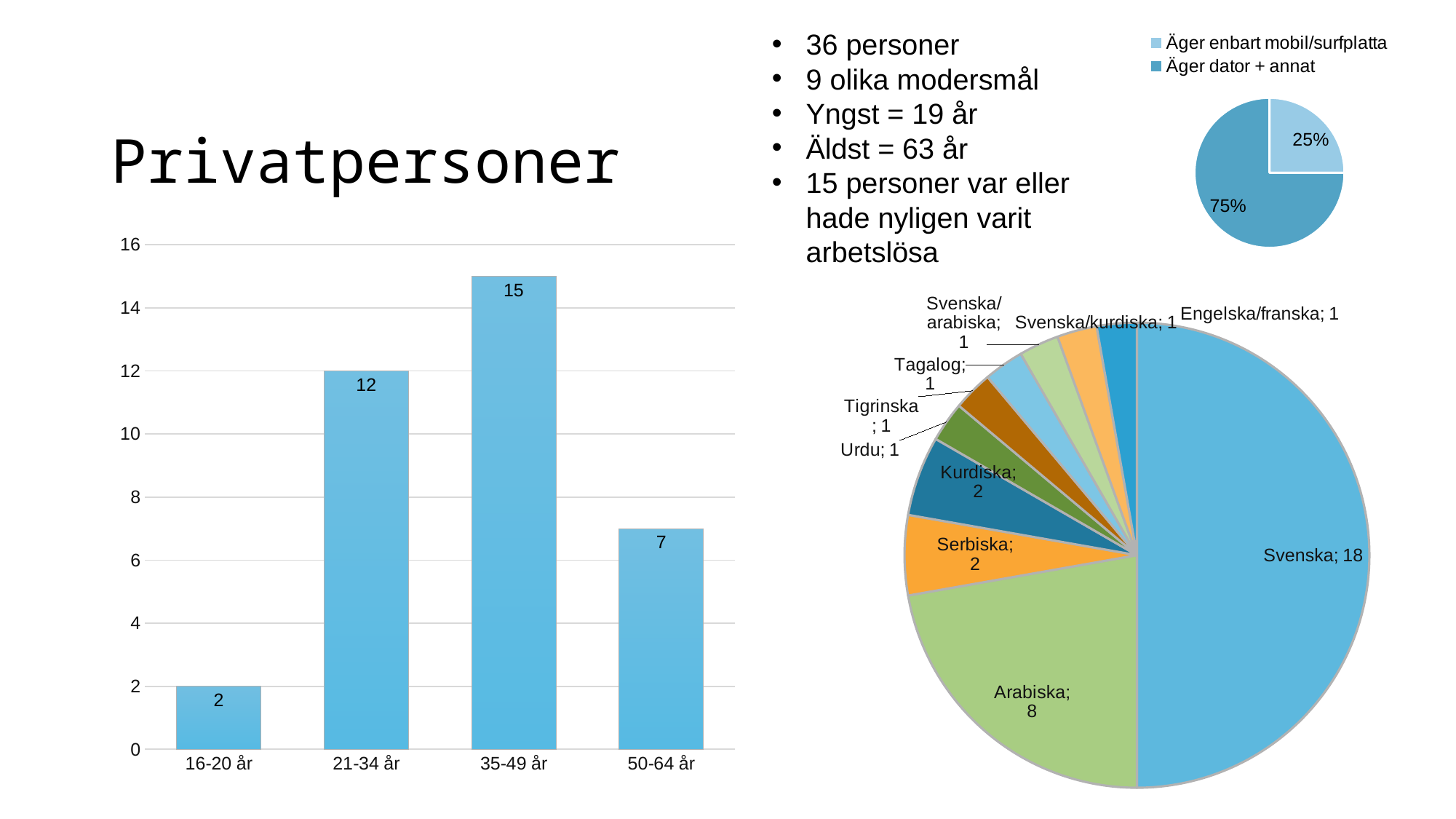
On the large pie chart at the bottom right, what is the value for Arabiska? 8 On the small pie chart at the top right, what percentage is shown for Äger dator + annat? 75% On the bar chart on the left, what is the value for 35-49 år? 15 On the bar chart on the left, how many age groups are shown? 4 How many entries does the legend of the small pie chart at the top right list? 2 On the bar chart on the left, which age group has the lowest value? 16-20 år On the bar chart on the left, what is the value for 16-20 år? 2 On the bar chart on the left, what is the difference between the values for 21-34 år and 50-64 år? 5 On the large pie chart at the bottom right, which slice is the largest? Svenska On the bar chart on the left, which age group has the highest value? 35-49 år What kind of chart is the chart on the left of the slide? Bar chart On the large pie chart at the bottom right, what share of the total does the Svenska slice represent? 50%